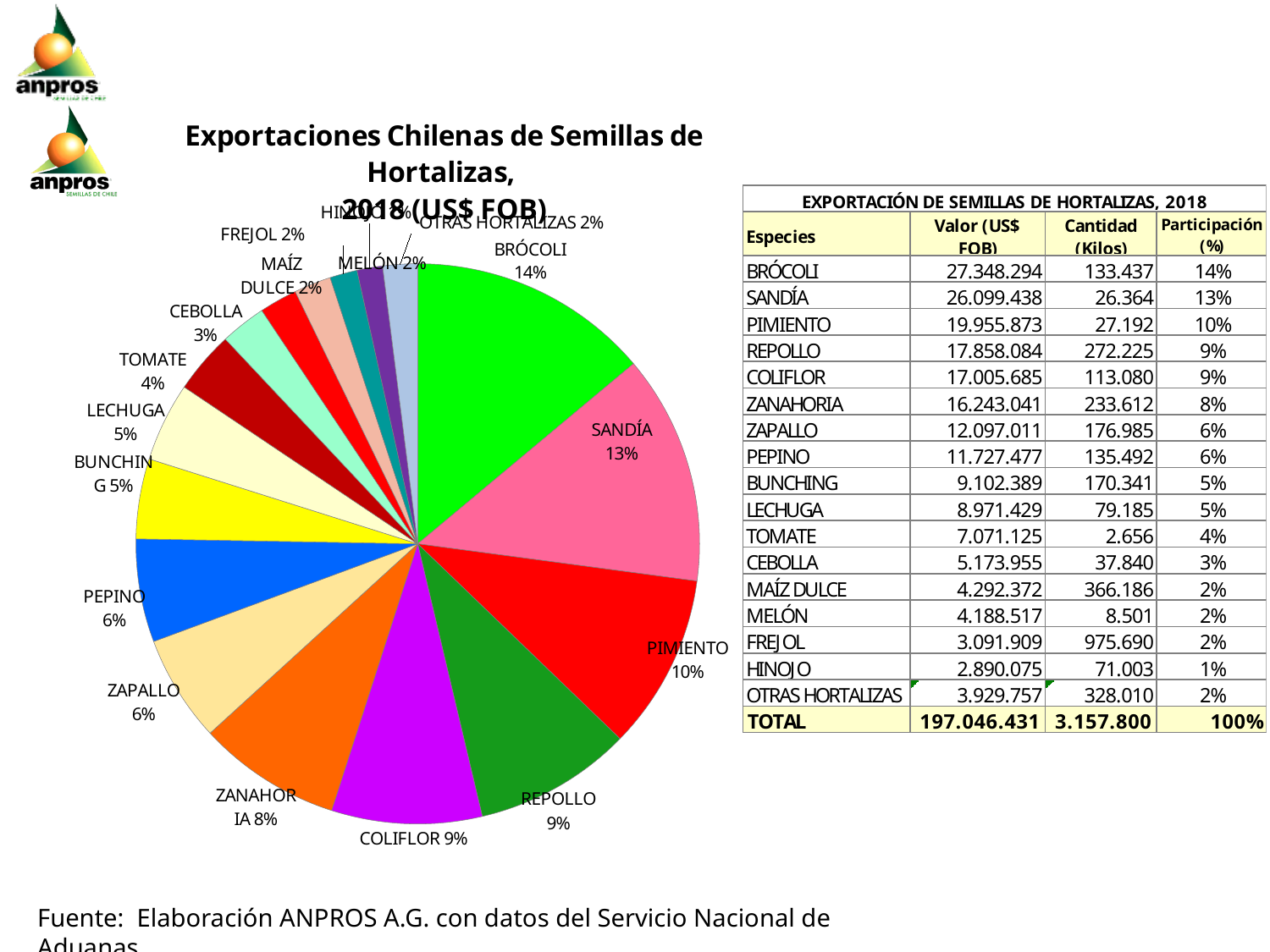
What share of the pie does CEBOLLA have? 3% What colour is the BRÓCOLI slice in the pie chart? green What share of the pie does ZANAHORIA have? 8% What share of the pie does PIMIENTO have? 10% What is the difference in percentage points between the SANDÍA slice and the ZAPALLO slice? 7 What kind of chart is shown on the slide? pie chart What is the difference in percentage points between the BRÓCOLI slice and the PIMIENTO slice? 4 Which is larger in the pie chart, the slice for PEPINO or the slice for TOMATE? PEPINO How many slices does the pie chart have? 17 Which species has the largest slice of the pie? BRÓCOLI